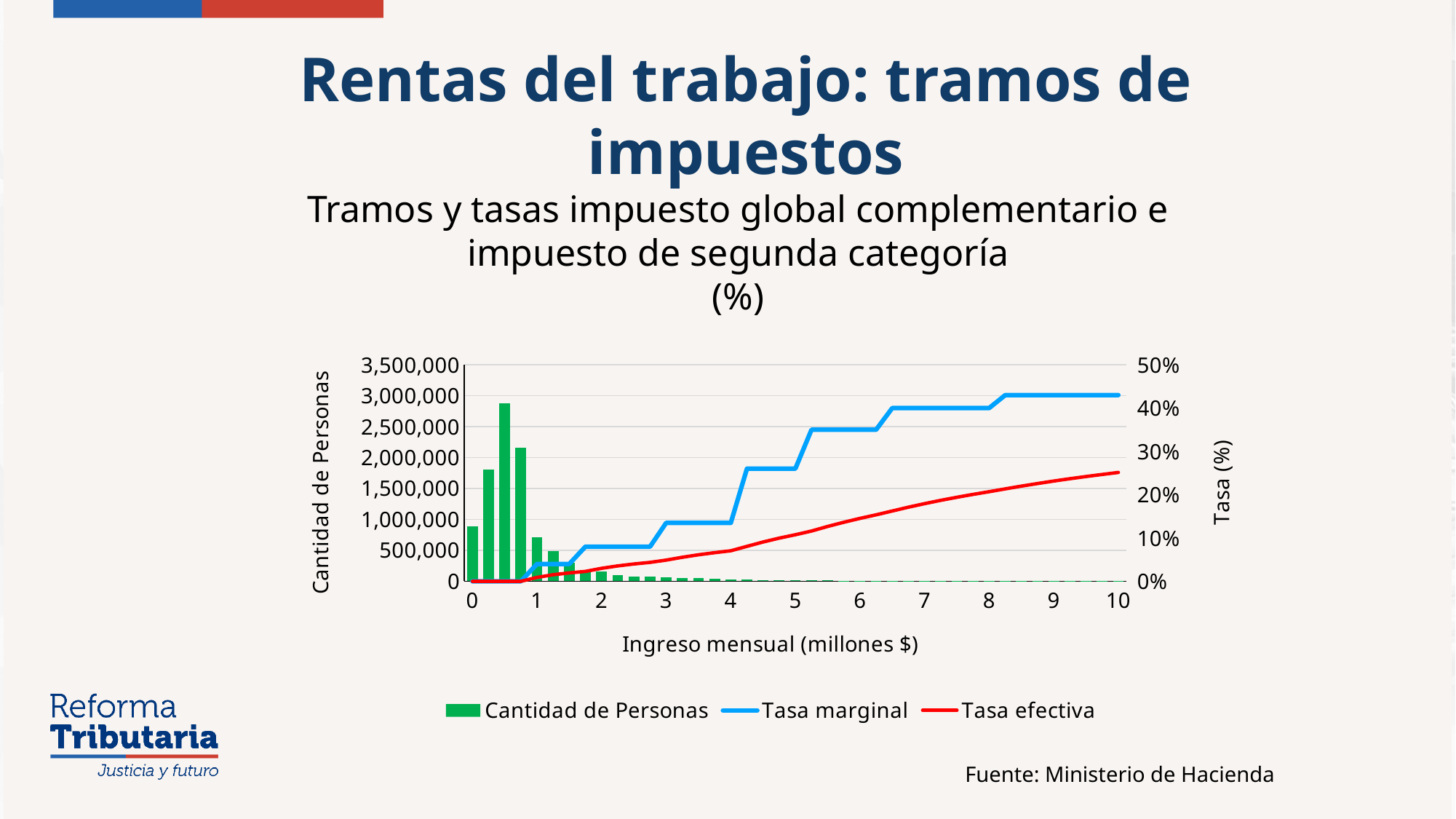
What is the label of the x axis of the chart? Ingreso mensual (millones $) Is the Tasa efectiva at a monthly income of 4 million greater or less than 10%? less What kind of chart is shown on the slide? Combined bar and line chart Does the Tasa efectiva line rise or fall as monthly income increases along the x axis? Rises Which series is drawn in red in the chart? Tasa efectiva At a monthly income of 10 million, which is higher, the Tasa marginal or the Tasa efectiva? Tasa marginal How many series does the chart legend list? 3 Is the value of the tallest Cantidad de Personas bar greater or less than 2,500,000? greater Is the Tasa marginal at a monthly income of 10 million greater or less than 40%? greater Which series reaches the highest rate on the right-hand axis? Tasa marginal